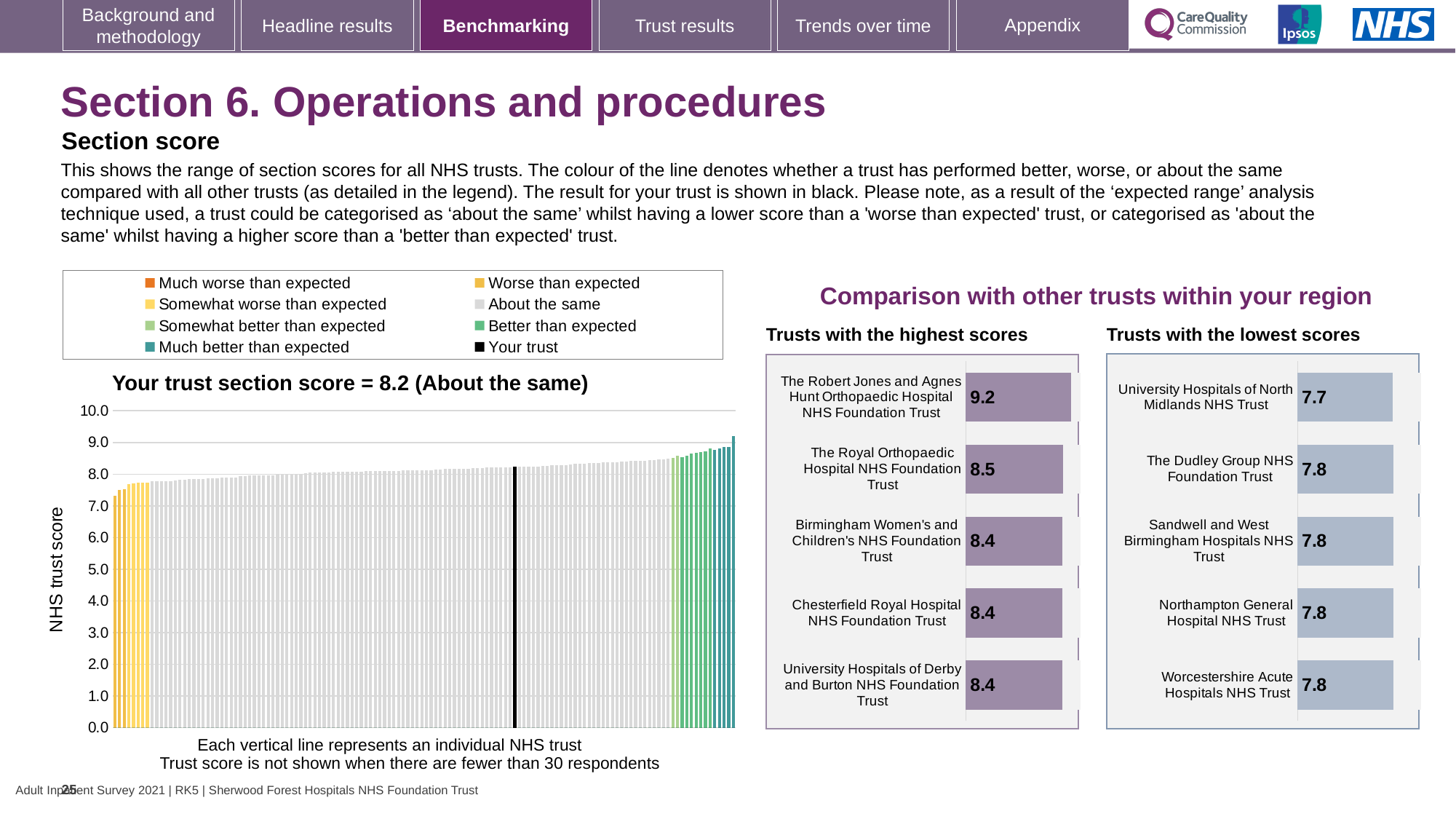
Which has the larger score: The Royal Orthopaedic Hospital NHS Foundation Trust in the highest scores chart, or The Dudley Group NHS Foundation Trust in the lowest scores chart? The Royal Orthopaedic Hospital NHS Foundation Trust In the 'Trusts with the highest scores' chart, what is the difference between the scores of The Robert Jones and Agnes Hunt Orthopaedic Hospital NHS Foundation Trust and The Royal Orthopaedic Hospital NHS Foundation Trust? 0.7 How many trusts are listed in the 'Trusts with the lowest scores' chart? 5 In the 'Trusts with the lowest scores' chart, what is the score for University Hospitals of North Midlands NHS Trust? 7.7 In the main chart titled 'Your trust section score = 8.2 (About the same)', do the bar values rise or fall from left to right? Rise What kind of chart is the main chart titled 'Your trust section score = 8.2 (About the same)'? Bar chart In the 'Trusts with the highest scores' chart, what is the score for The Robert Jones and Agnes Hunt Orthopaedic Hospital NHS Foundation Trust? 9.2 In the 'Trusts with the highest scores' chart, what is the score for The Royal Orthopaedic Hospital NHS Foundation Trust? 8.5 How many entries does the legend above the main chart list? 8 In the 'Trusts with the highest scores' chart, which trust has the highest score? The Robert Jones and Agnes Hunt Orthopaedic Hospital NHS Foundation Trust In the 'Trusts with the lowest scores' chart, which trust has the lowest score? University Hospitals of North Midlands NHS Trust In the main chart titled 'Your trust section score = 8.2 (About the same)', what is the section score for your trust? 8.2